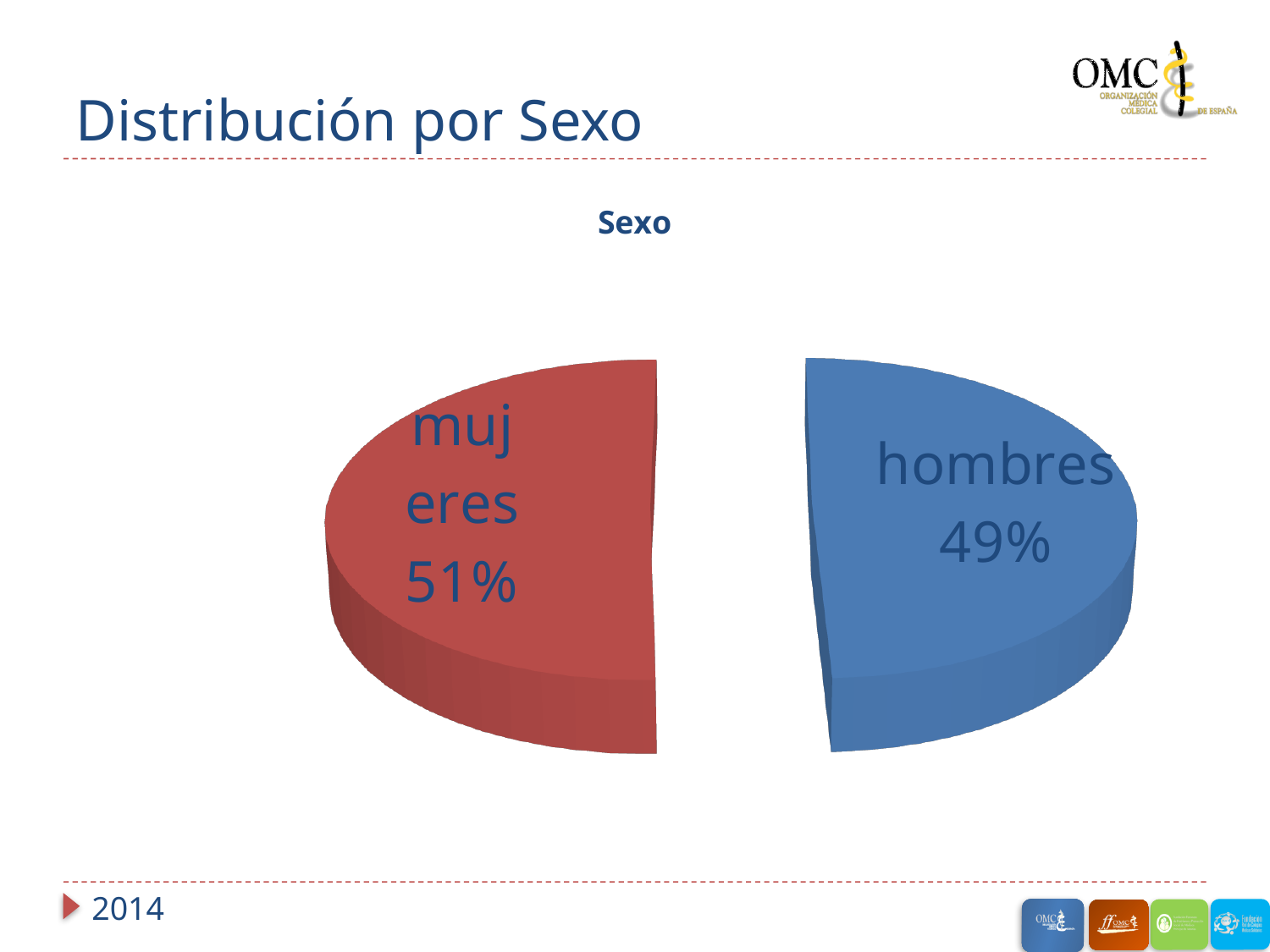
What is the difference in percentage points between the 'mujeres' and 'hombres' shares? 2% Is the share for 'hombres' greater or less than 50%? less How many slices does the pie chart have? 2 What colour is the 'hombres' slice? blue Which category has the smallest share of the pie? hombres What share of the pie does the 'mujeres' slice represent? 51% Is the share for 'mujeres' greater or less than 50%? greater What kind of chart is shown on the slide? pie chart Which is larger, the share for 'mujeres' or the share for 'hombres'? mujeres What is the title of the chart? Sexo What share of the pie does the 'hombres' slice represent? 49% Which category has the largest share of the pie? mujeres